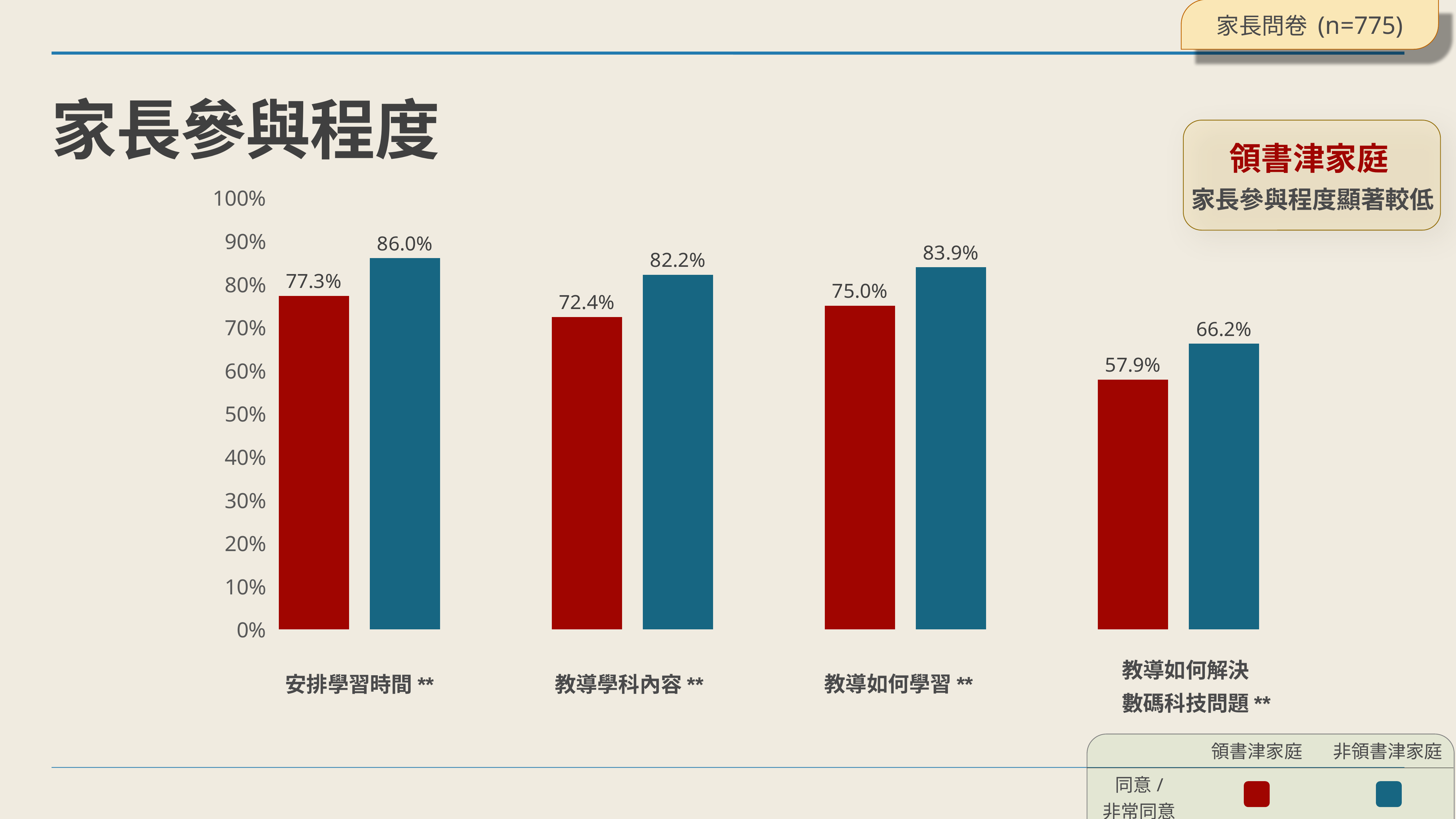
How many series does the legend list? 2 Which category has the lowest value for 領書津家庭? 教導如何解決數碼科技問題 In the 教導學科內容 category, which series has the larger value, 領書津家庭 or 非領書津家庭? 非領書津家庭 Is the value for 非領書津家庭 in the 教導如何解決數碼科技問題 category greater or less than 70%? less What is the value for 領書津家庭 in the 教導如何解決數碼科技問題 category? 57.9% What is the difference between 非領書津家庭 and 領書津家庭 in the 教導如何學習 category? 8.9% What is the value for 非領書津家庭 in the 教導學科內容 category? 82.2% How many categories are shown on the x axis? 4 What kind of chart is shown on the slide? bar chart What is the value for 領書津家庭 in the 安排學習時間 category? 77.3% Which category has the highest value for 非領書津家庭? 安排學習時間 What colour represents 領書津家庭 in the chart? red